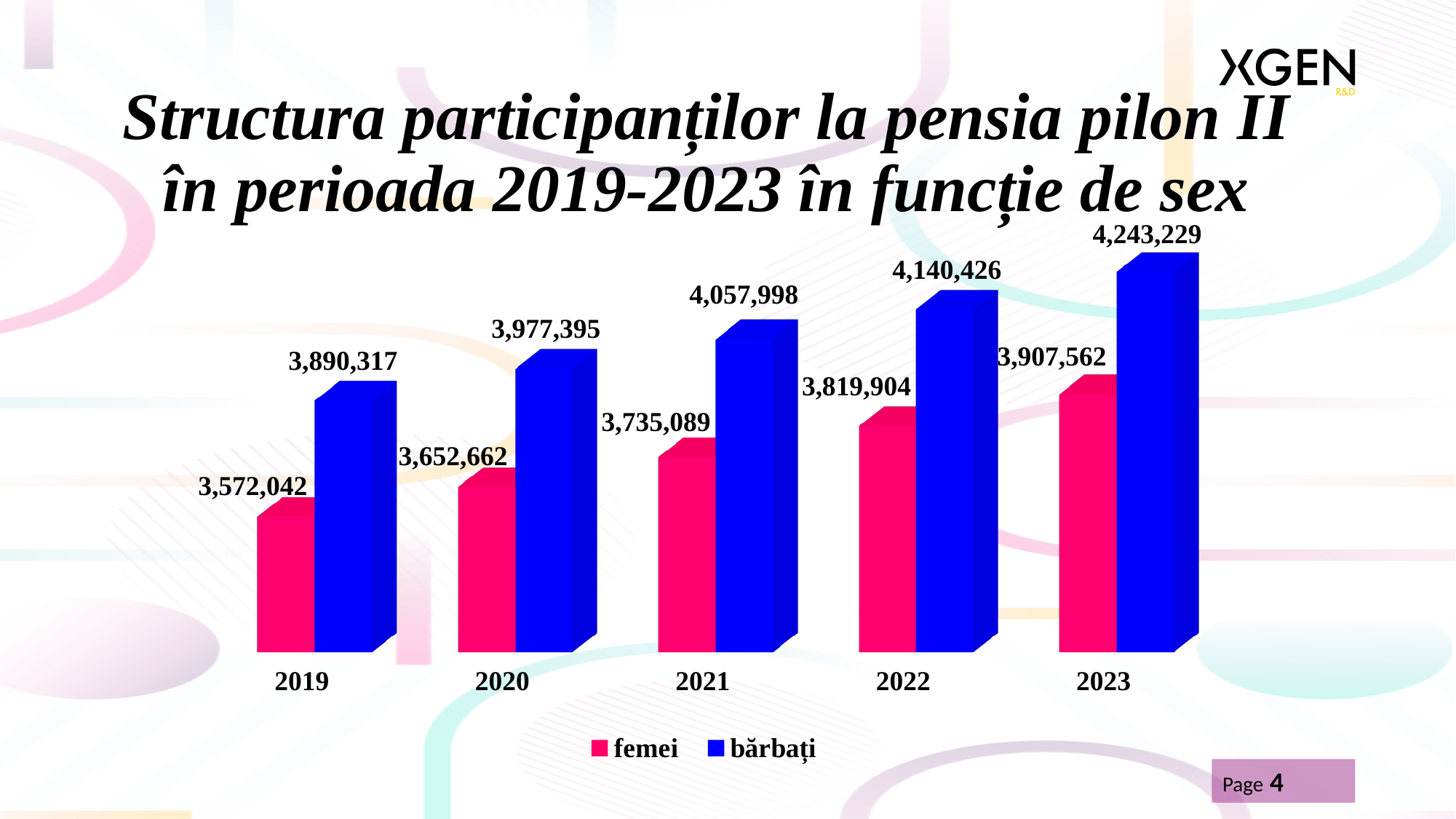
What is the value for bărbați in 2020? 3,977,395 What is the value for bărbați in 2023? 4,243,229 In which year is the femei value lowest? 2019 How many series does the legend list? 2 What is the value for femei in 2019? 3,572,042 What is the difference between the bărbați and femei values in 2023? 335,667 By how much did the femei value increase from 2019 to 2023? 335,520 Which is larger in 2022, the femei value or the bărbați value? bărbați What is the value for femei in 2021? 3,735,089 Do the bărbați values rise or fall from 2019 to 2023? rise How many years are shown on the x axis? 5 In which year is the bărbați value highest? 2023